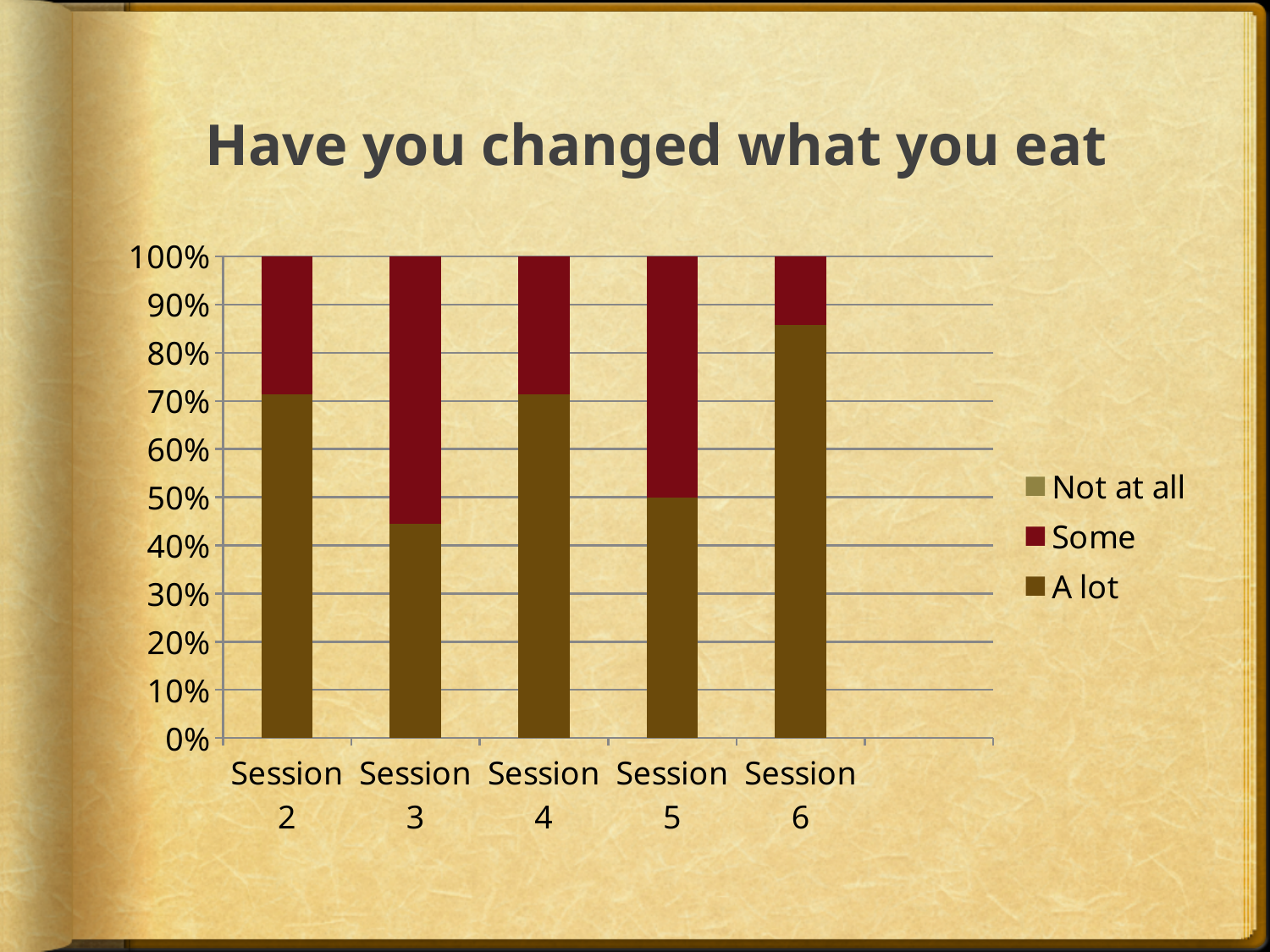
Which series is shown in dark red in the chart? Some What is the title of the chart? Have you changed what you eat Is the 'A lot' share for Session 3 greater or less than 50%? less Which session has the largest share of 'Some' responses? Session 3 Which session has the smallest share of 'Some' responses? Session 6 How many sessions are shown on the x axis of the chart? 5 Is the 'A lot' share for Session 6 greater or less than 80%? greater Which session has the highest share of 'A lot' responses? Session 6 What kind of chart is shown on the slide? stacked bar chart How many series does the chart's legend list? 3 Which session has the lowest share of 'A lot' responses? Session 3 Which session has a larger 'A lot' share, Session 3 or Session 5? Session 5